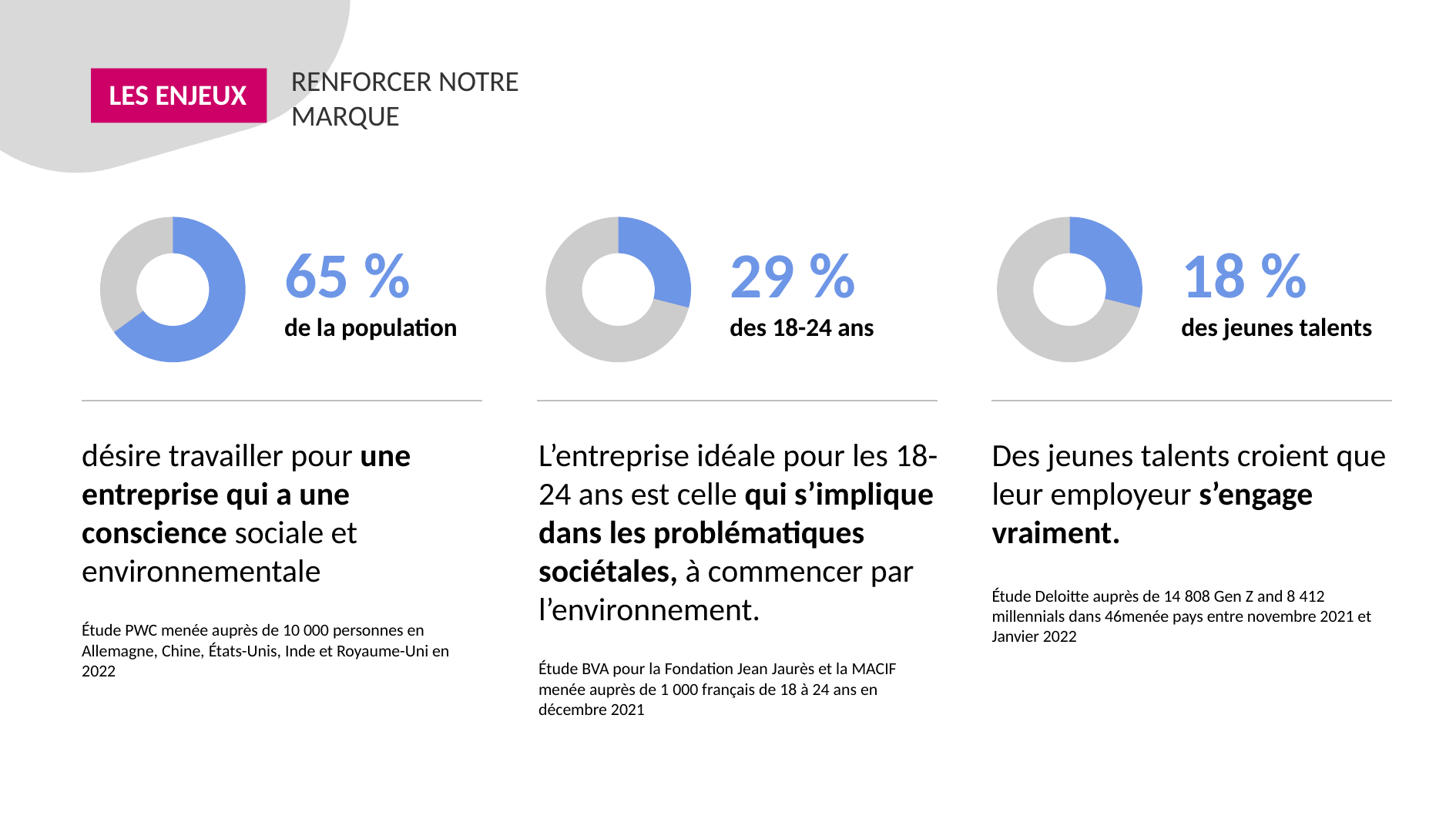
What is the difference between the percentage in the left chart (de la population) and the middle chart (des 18-24 ans)? 36 % Which is larger: the percentage in the middle chart (des 18-24 ans) or the right chart (des jeunes talents)? The middle chart (29 %) What kind of chart is used to display the three percentages on the slide? Donut (pie) chart Which of the three donut charts shows the lowest percentage? The right chart, 'des jeunes talents' (18 %) How many donut charts are shown on the slide? 3 In the middle donut chart labelled 'des 18-24 ans', what percentage is shown? 29 % What colour is used for the highlighted portion in each donut chart? Blue In the right donut chart labelled 'des jeunes talents', what percentage is shown? 18 % Is the blue share in the left donut chart (de la population) greater or less than 50 %? greater Which of the three donut charts shows the highest percentage? The left chart, 'de la population' (65 %) In the left donut chart (de la population), what share of the ring is grey (not highlighted)? 35 % In the left donut chart labelled 'de la population', what percentage is shown? 65 %